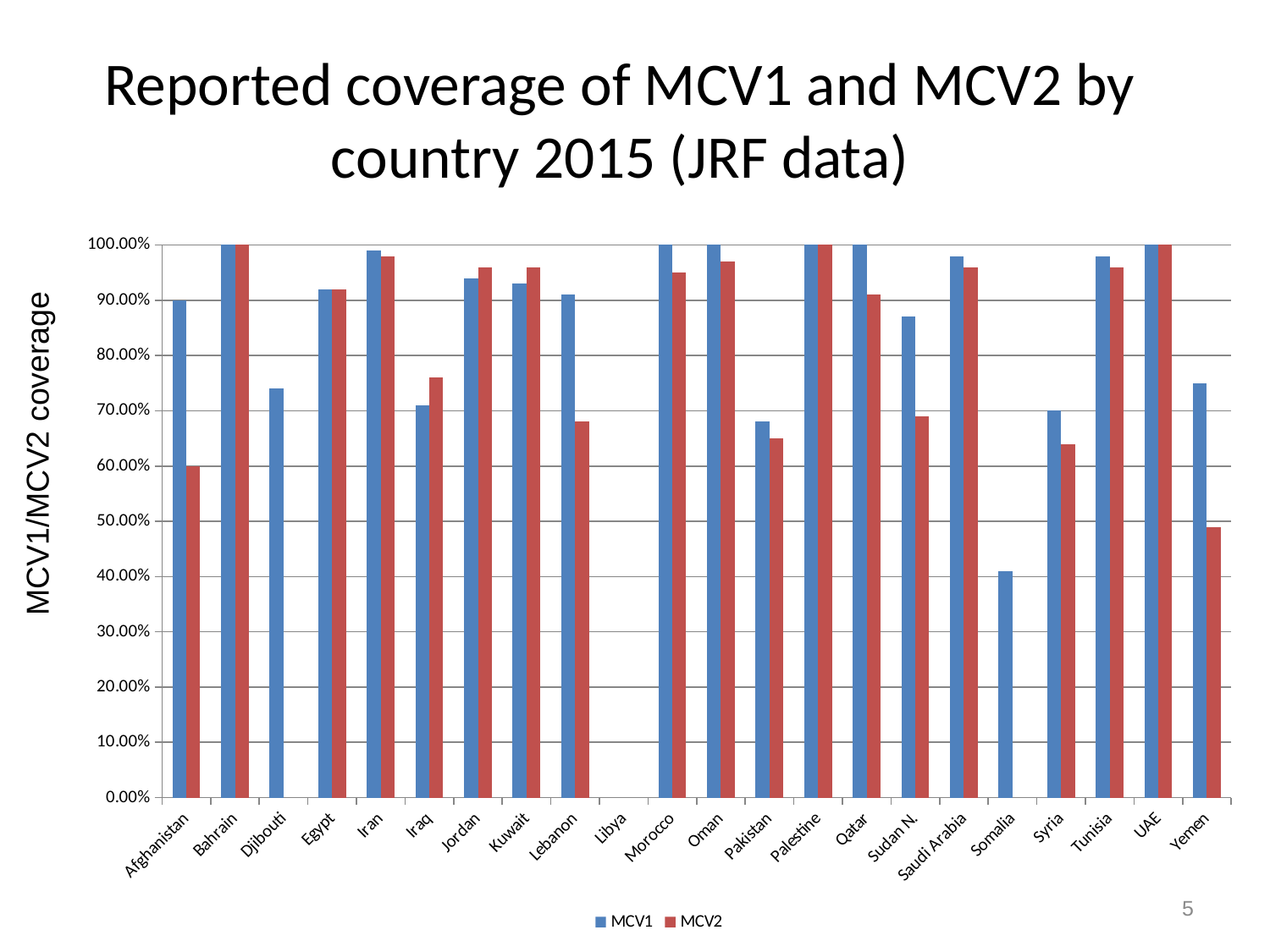
Is the MCV1 value for Somalia greater or less than 50%? less How many countries are shown on the x axis? 22 What is the MCV2 coverage for Afghanistan? 60.00% What is the MCV1 coverage for Bahrain? 100.00% Is the MCV2 value for Iraq greater or less than 70%? greater Which country has the lowest MCV1 coverage? Somalia What is the title of the chart? Reported coverage of MCV1 and MCV2 by country 2015 (JRF data) How many series does the legend list? 2 What kind of chart is shown on the slide? Bar chart For Yemen, which is larger, MCV1 or MCV2 coverage? MCV1 What is the MCV1 coverage for Afghanistan? 90.00% Which country has the lowest MCV2 coverage among those with an MCV2 bar? Yemen